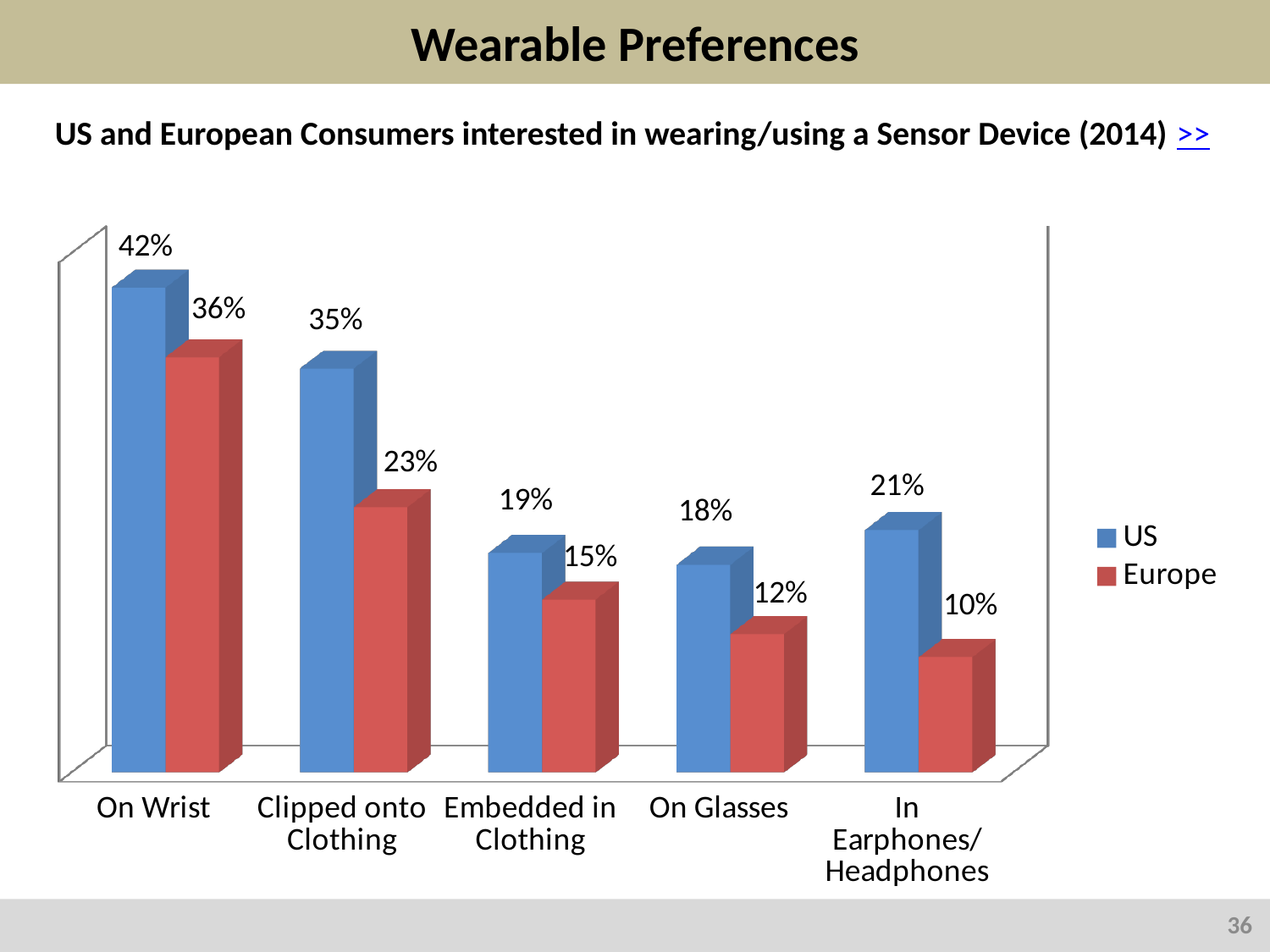
Which is larger, the US value for On Glasses or the US value for In Earphones/Headphones? In Earphones/Headphones What is the difference between the US and Europe values for On Wrist? 6% What is the difference between the US and Europe values for In Earphones/Headphones? 11% Which category has the lowest Europe value? In Earphones/Headphones What is the Europe value for Clipped onto Clothing? 23% What is the US value for On Wrist? 42% Which category has the highest US value? On Wrist Which series is shown in red in the legend? Europe What is the Europe value for In Earphones/Headphones? 10% How many categories are shown on the x axis? 5 How many series does the legend list? 2 What kind of chart is shown on the slide? Bar chart